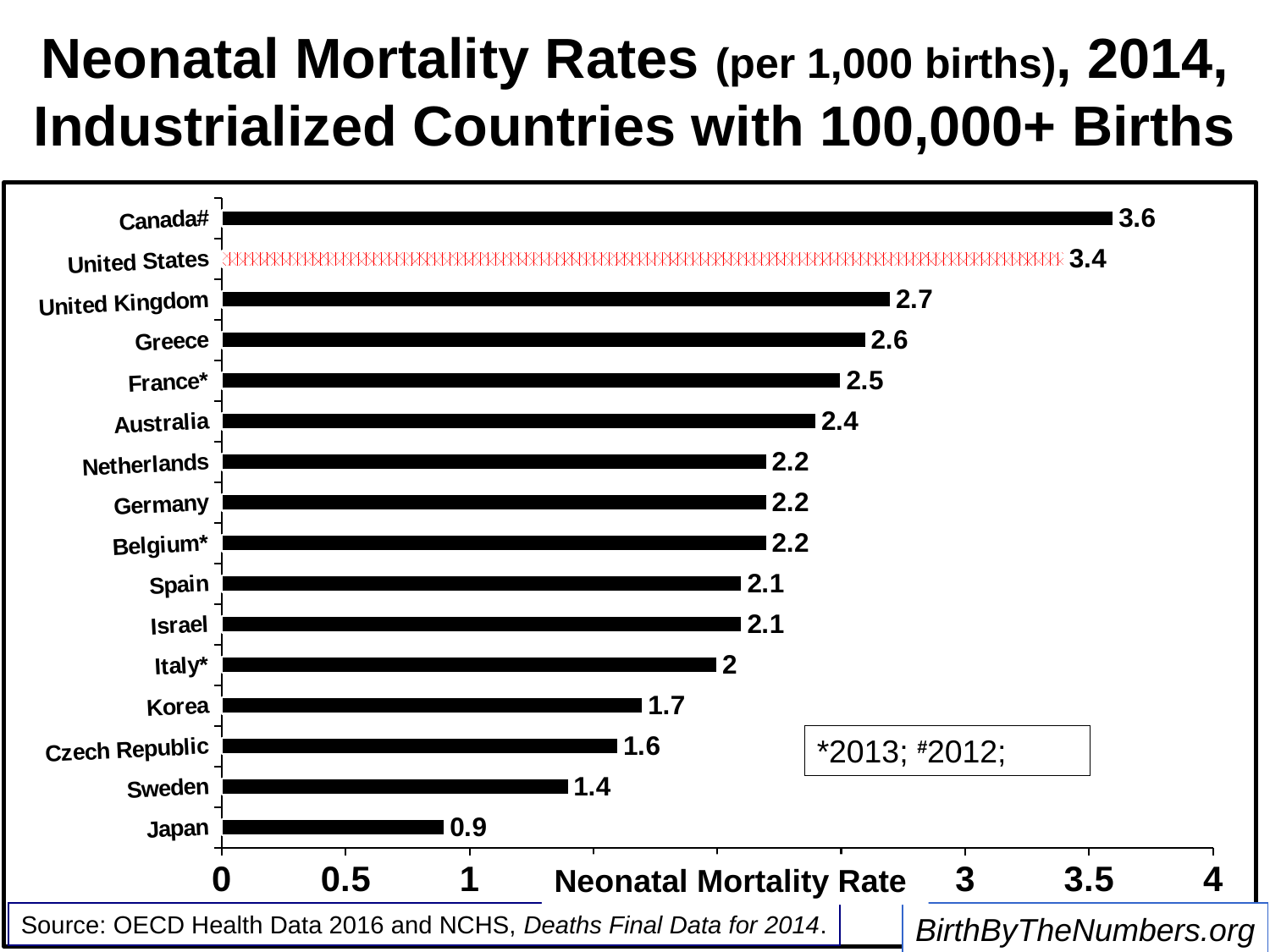
What is the neonatal mortality rate for Greece? 2.6 How many countries are shown in the chart? 16 Which country has the highest neonatal mortality rate? Canada# What kind of chart is shown on the slide? bar chart Which country has the lowest neonatal mortality rate? Japan What is the difference between the neonatal mortality rates of the United Kingdom and Sweden? 1.3 What is the neonatal mortality rate for the United States? 3.4 What is the difference between the neonatal mortality rates of Canada# and the United States? 0.2 What is the neonatal mortality rate for Japan? 0.9 Which has a higher neonatal mortality rate, Korea or Australia? Australia Which country's bar is drawn with a red hatched pattern instead of solid black? United States Is the neonatal mortality rate for France* greater or less than 2? greater